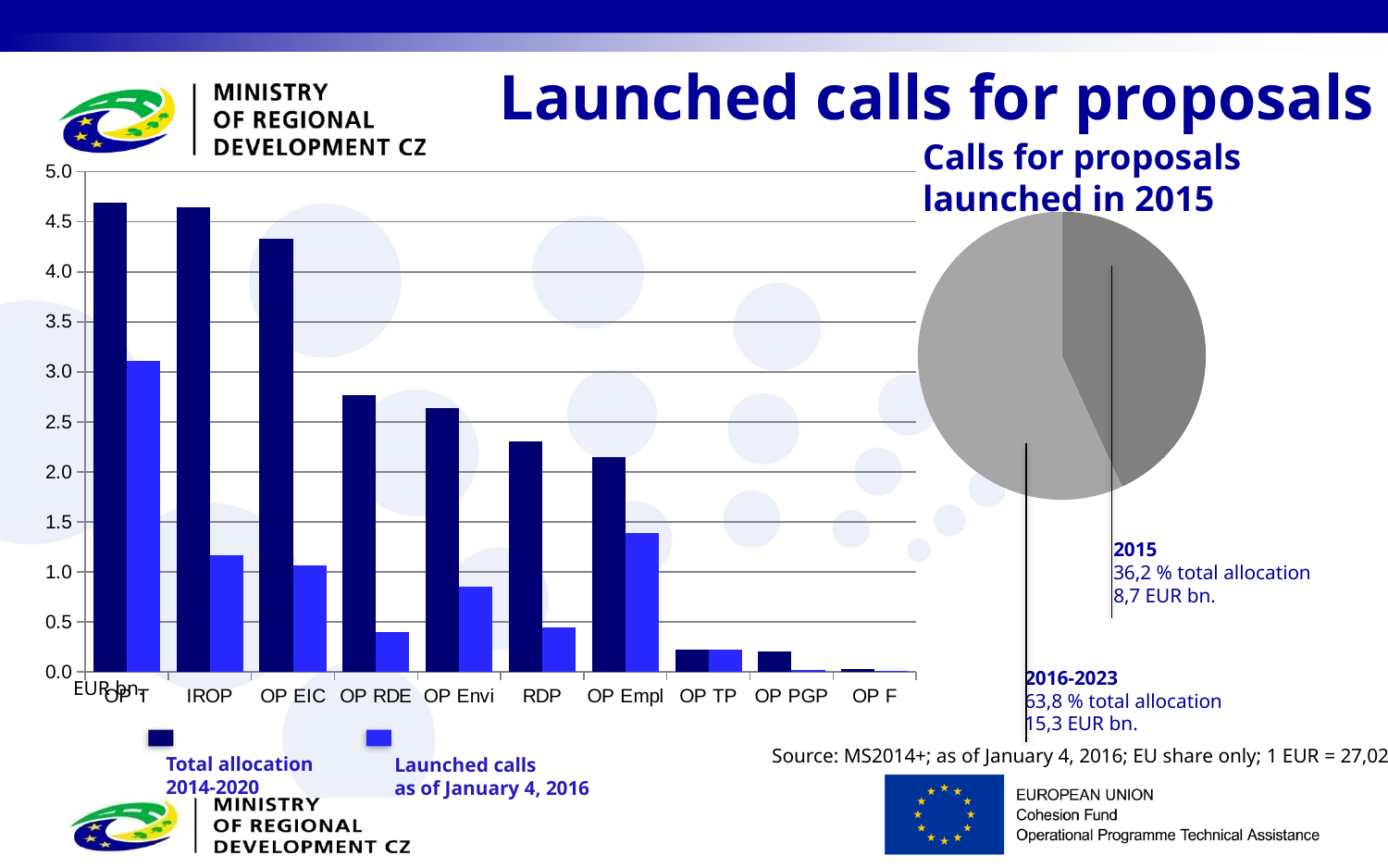
What kind of chart is the chart on the left of the slide? bar chart How many programme categories are shown on the x axis of the bar chart on the left? 10 In the bar chart on the left, which programme has the highest value for Launched calls as of January 4, 2016? OP T In the bar chart on the left, which programme has the highest Total allocation 2014-2020? OP T In the bar chart on the left, is the Launched calls as of January 4, 2016 value for OP Envi greater or less than 1.0? less In the pie chart 'Calls for proposals launched in 2015', how much larger is the 2016-2023 amount than the 2015 amount? 6,6 EUR bn. In the pie chart 'Calls for proposals launched in 2015', what share of the total allocation is for 2015? 36,2 % In the bar chart on the left, is the Total allocation 2014-2020 for OP EIC greater or less than 4.5? less In the bar chart on the left, which programme has the lowest Total allocation 2014-2020? OP F How many series does the legend of the bar chart on the left list? 2 In the pie chart 'Calls for proposals launched in 2015', what is the amount for 2016-2023? 15,3 EUR bn. In the bar chart on the left, which has the larger Launched calls as of January 4, 2016 value, OP Empl or OP Envi? OP Empl